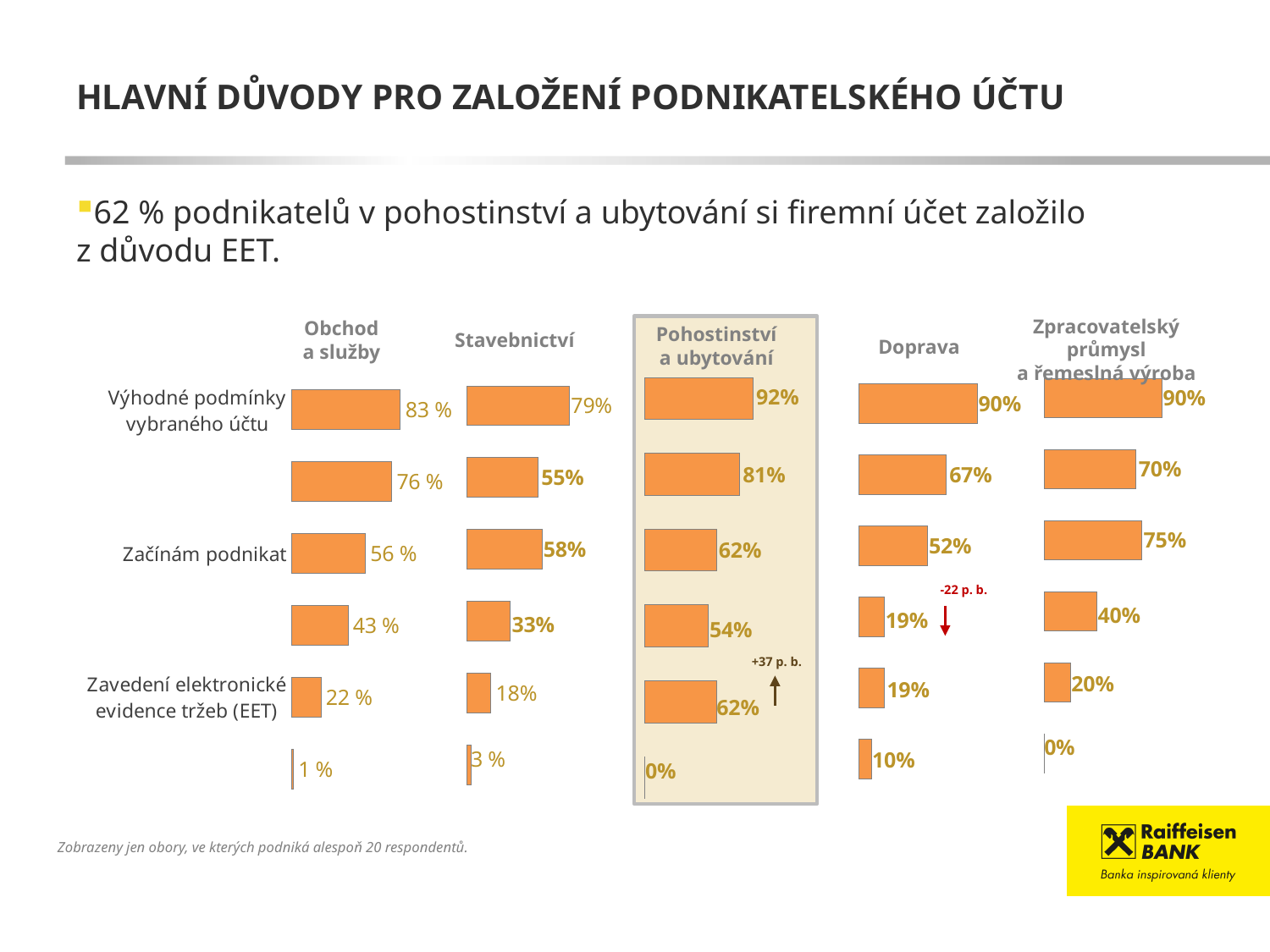
In the Obchod a služby chart, what is the value for Výhodné podmínky vybraného účtu? 83 % What is the difference between the Pohostinství a ubytování and Obchod a služby values for Zavedení elektronické evidence tržeb (EET)? 40 percentage points In the Zpracovatelský průmysl a řemeslná výroba chart, what is the value for Začínám podnikat? 75% Across the five sector charts, which sector has the highest value for Výhodné podmínky vybraného účtu? Pohostinství a ubytování How many sector charts are shown on the slide? 5 What type of chart is used on this slide? Bar chart Across the five sector charts, which sector has the lowest value for Zavedení elektronické evidence tržeb (EET)? Stavebnictví For Začínám podnikat, which is larger: the Stavebnictví value or the Doprava value? Stavebnictví In the Pohostinství a ubytování chart, what is the value for Zavedení elektronické evidence tržeb (EET)? 62% In the Stavebnictví chart, what is the value for Zavedení elektronické evidence tržeb (EET)? 18% In the Doprava chart, what is the value for Začínám podnikat? 52% What is the difference between the Výhodné podmínky vybraného účtu values for Obchod a služby and Stavebnictví? 4 percentage points